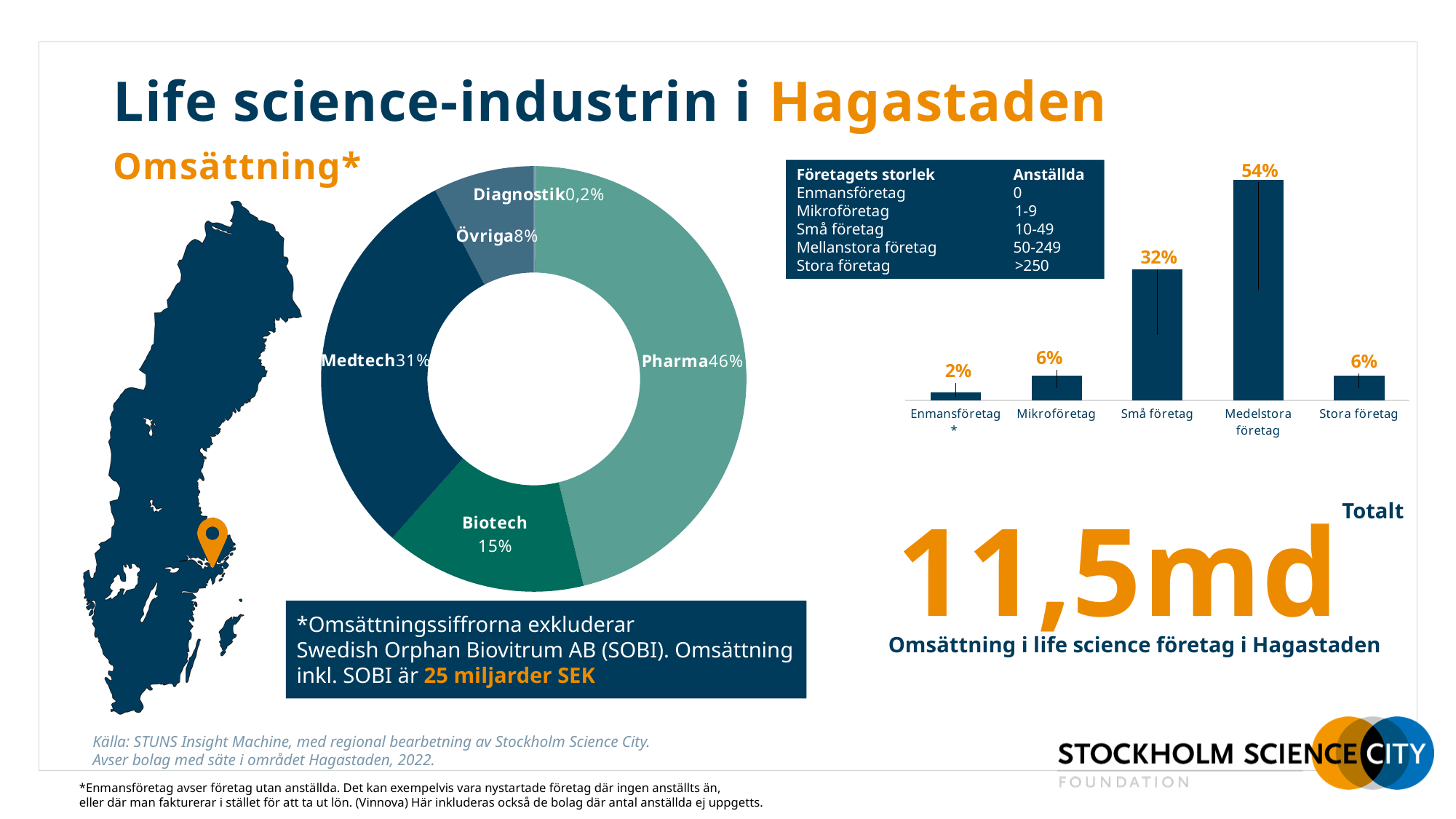
In the donut chart on the left, what is the value for Biotech? 15% In the bar chart on the right, which category has the lowest value? Enmansföretag In the donut chart on the left, what share of Omsättning does Pharma account for? 46% What type of chart is shown on the right side of the slide? Bar chart In the bar chart on the right, what is the value for Små företag? 32% In the donut chart on the left, which sector has the largest share? Pharma In the donut chart on the left, which sector has the smallest share? Diagnostik In the bar chart on the right, which is larger: Små företag or Stora företag? Små företag In the bar chart on the right, what is the difference between Medelstora företag and Små företag? 22% In the bar chart on the right, what is the value for Medelstora företag? 54% How many sectors are shown in the donut chart on the left? 5 In the donut chart on the left, what is the difference between the Pharma and Medtech shares? 15%